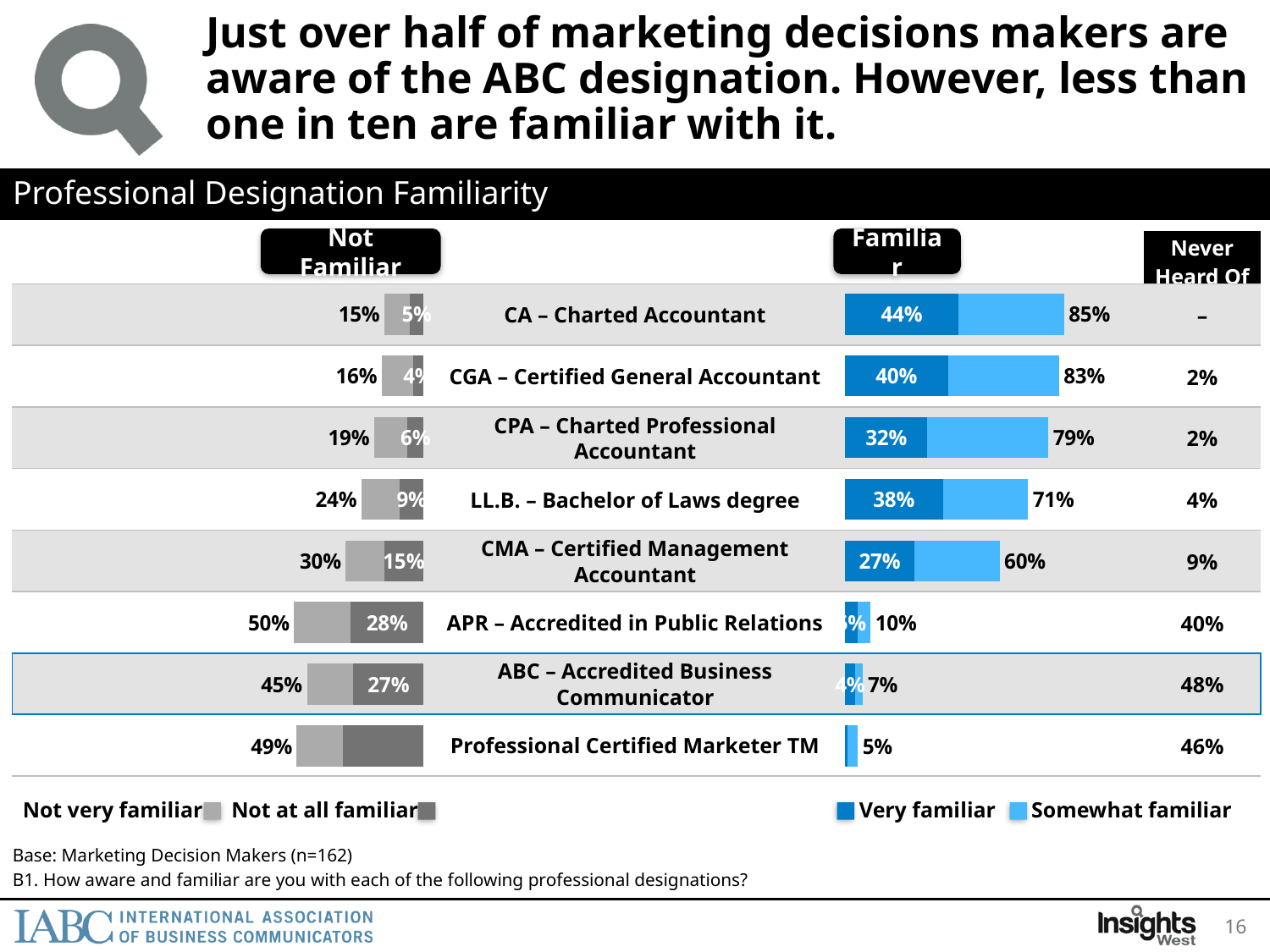
What is the Familiar percentage for CA – Charted Accountant? 85% Which has a higher Not Familiar percentage, LL.B. – Bachelor of Laws degree or CPA – Charted Professional Accountant? LL.B. – Bachelor of Laws degree Which designation has the highest Familiar percentage? CA – Charted Accountant Which designation has the lowest Familiar percentage? Professional Certified Marketer TM Which designation has the highest Never Heard Of percentage? ABC – Accredited Business Communicator What is the Never Heard Of percentage for ABC – Accredited Business Communicator? 48% What type of chart is shown on the slide? Bar chart How many professional designations are listed in the chart? 8 What is the difference between the Familiar percentages for CA – Charted Accountant and CMA – Certified Management Accountant? 25% How many series do the legends list in total? 4 What is the Very familiar percentage for CGA – Certified General Accountant? 40% What is the Not Familiar percentage for APR – Accredited in Public Relations? 50%